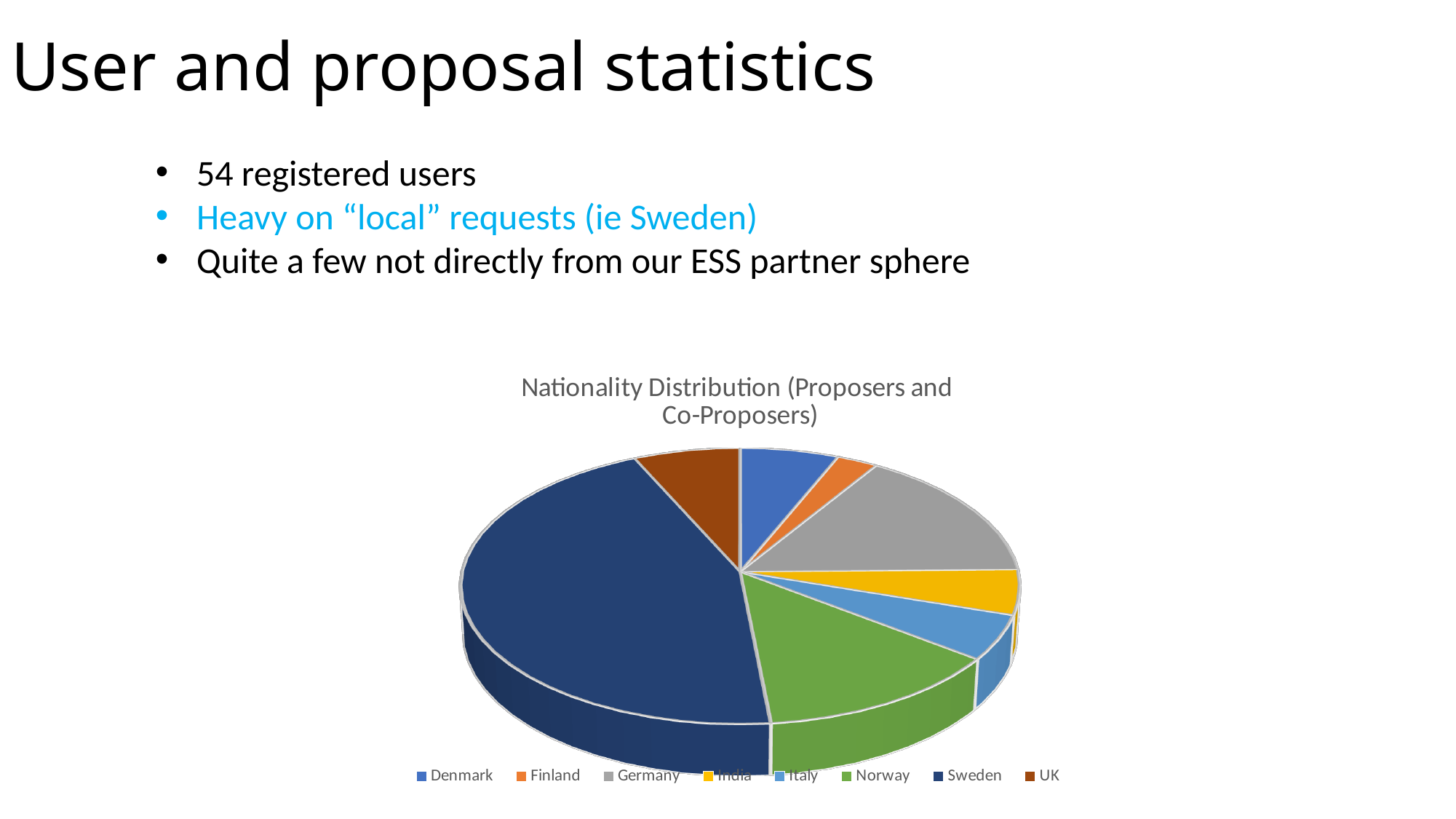
Which nationality has the smallest slice of the pie chart? Finland Which slice is larger, Finland or UK? UK Which slice is larger, Germany or Denmark? Germany Which nationality is represented by the green slice? Norway What is the title of the chart? Nationality Distribution (Proposers and Co-Proposers) Which slice is larger, Sweden or Germany? Sweden Which nationality has the largest slice of the pie chart? Sweden How many nationalities (categories) does the pie chart show? 8 What kind of chart is shown on the slide? Pie chart